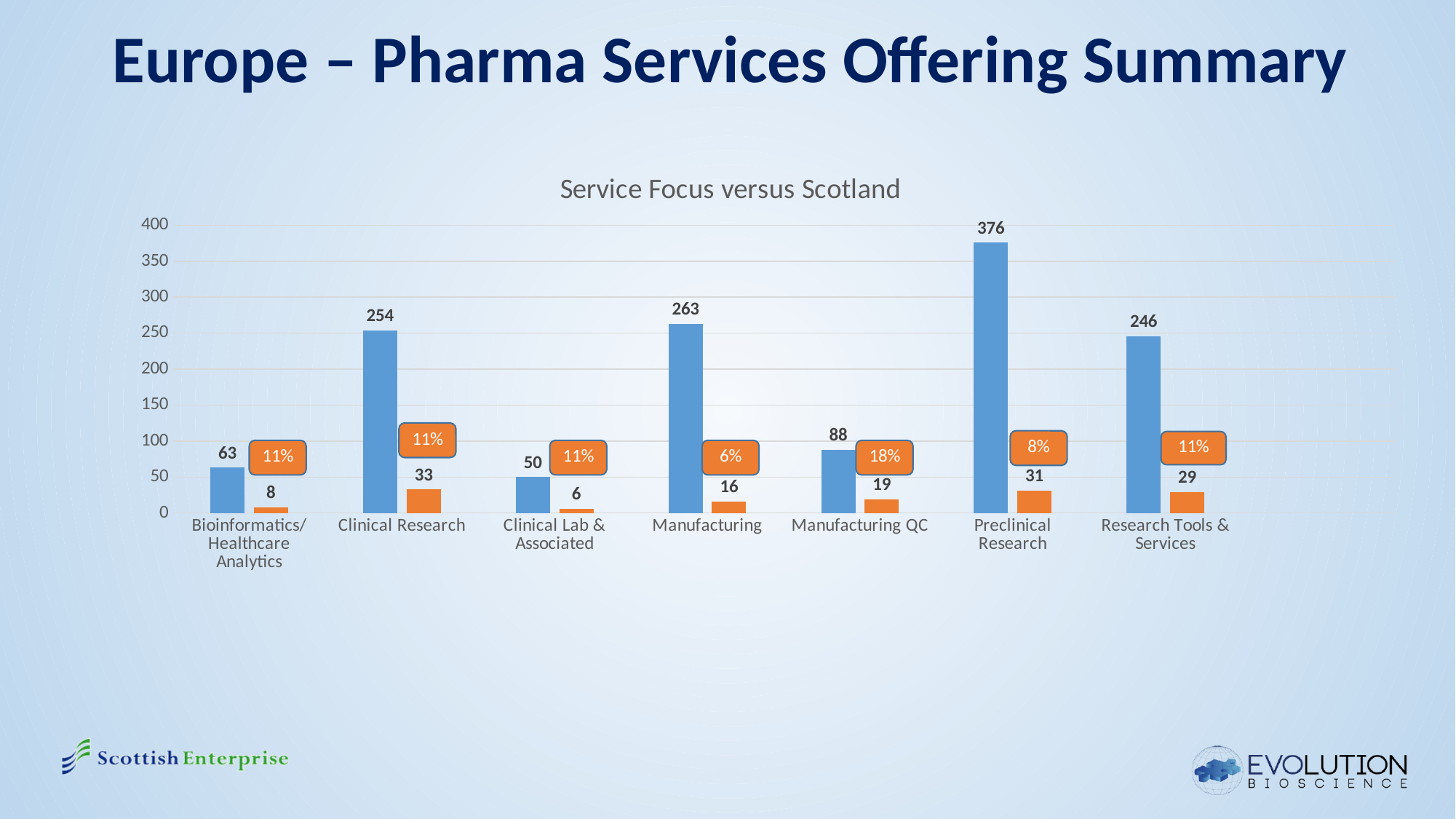
Which category has the lowest orange bar? Clinical Lab & Associated Which category has the highest blue bar? Preclinical Research How many categories are shown on the x axis? 7 What is the value of the orange bar for Clinical Lab & Associated? 6 Is the blue bar for Bioinformatics/Healthcare Analytics greater or less than 100? less What is the value of the blue bar for Manufacturing QC? 88 What is the difference between the blue bar values for Manufacturing and Clinical Research? 9 What is the value of the orange bar for Clinical Research? 33 What type of chart is shown? Bar chart What percentage is shown in the orange box for Manufacturing QC? 18% Which is larger, the blue bar for Research Tools & Services or the blue bar for Clinical Research? Clinical Research What is the value of the blue bar for Preclinical Research? 376